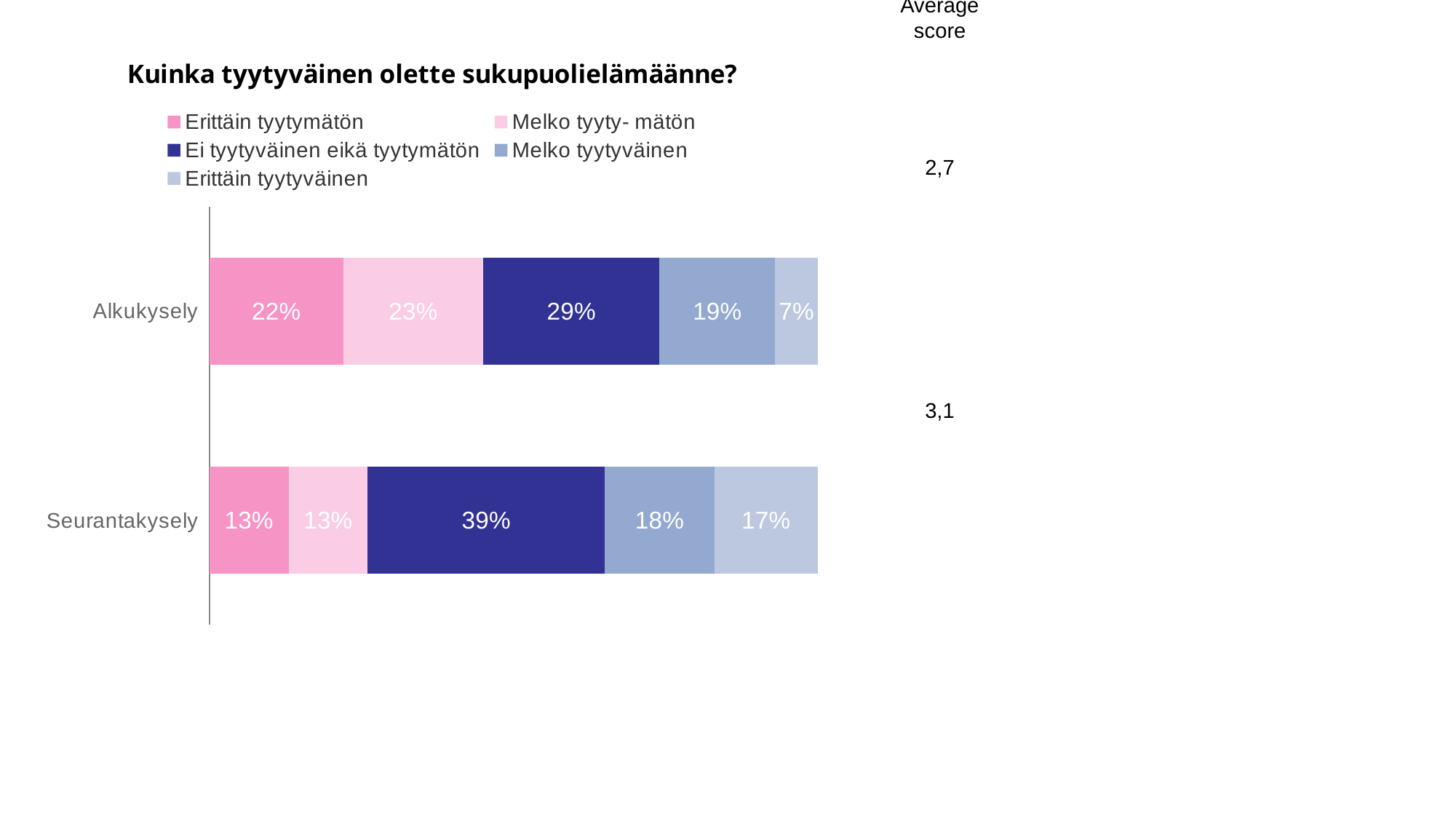
How many categories (bars) does the chart show? 2 Which bar has the larger "Erittäin tyytymätön" value, Alkukysely or Seurantakysely? Alkukysely What kind of chart is shown on the slide? Stacked bar chart What is the value for "Ei tyytyväinen eikä tyytymätön" in the Alkukysely bar? 29% What is the difference between the "Ei tyytyväinen eikä tyytymätön" values for Seurantakysely and Alkukysely? 10 percentage points What is the title of the chart? Kuinka tyytyväinen olette sukupuolielämäänne? Which segment is the largest in the Seurantakysely bar? Ei tyytyväinen eikä tyytymätön What is the value for "Melko tyytyväinen" in the Seurantakysely bar? 18% How many series does the legend list? 5 What is the value for "Erittäin tyytyväinen" in the Seurantakysely bar? 17% Which segment is the smallest in the Alkukysely bar? Erittäin tyytyväinen What is the value for "Erittäin tyytymätön" in the Alkukysely bar? 22%